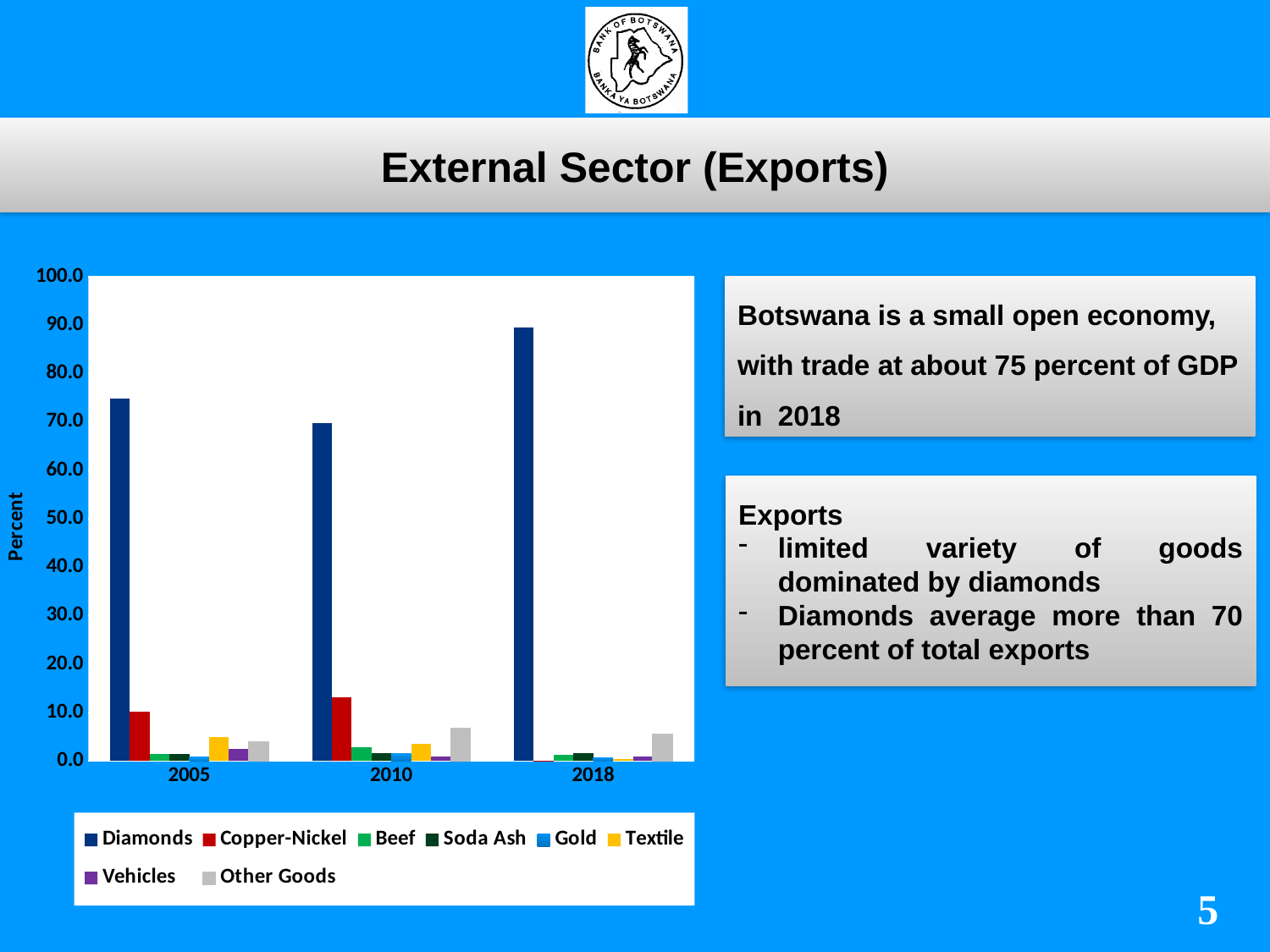
In which year is the Diamonds bar lowest? 2010 Is the value for Copper-Nickel in 2010 greater or less than 10? greater Is the value for Diamonds in 2005 greater or less than 70? greater What is the label on the chart's vertical axis? Percent How many years are shown on the x axis of the chart? 3 Which series has the highest bar in 2018? Diamonds How many series does the chart's legend list? 8 Which is larger, the Diamonds value in 2005 or in 2018? 2018 In which year is the Diamonds bar highest? 2018 Is the value for Diamonds in 2018 greater or less than 80? greater Which is larger, the Copper-Nickel value in 2005 or in 2010? 2010 What kind of chart is shown on the slide? bar chart